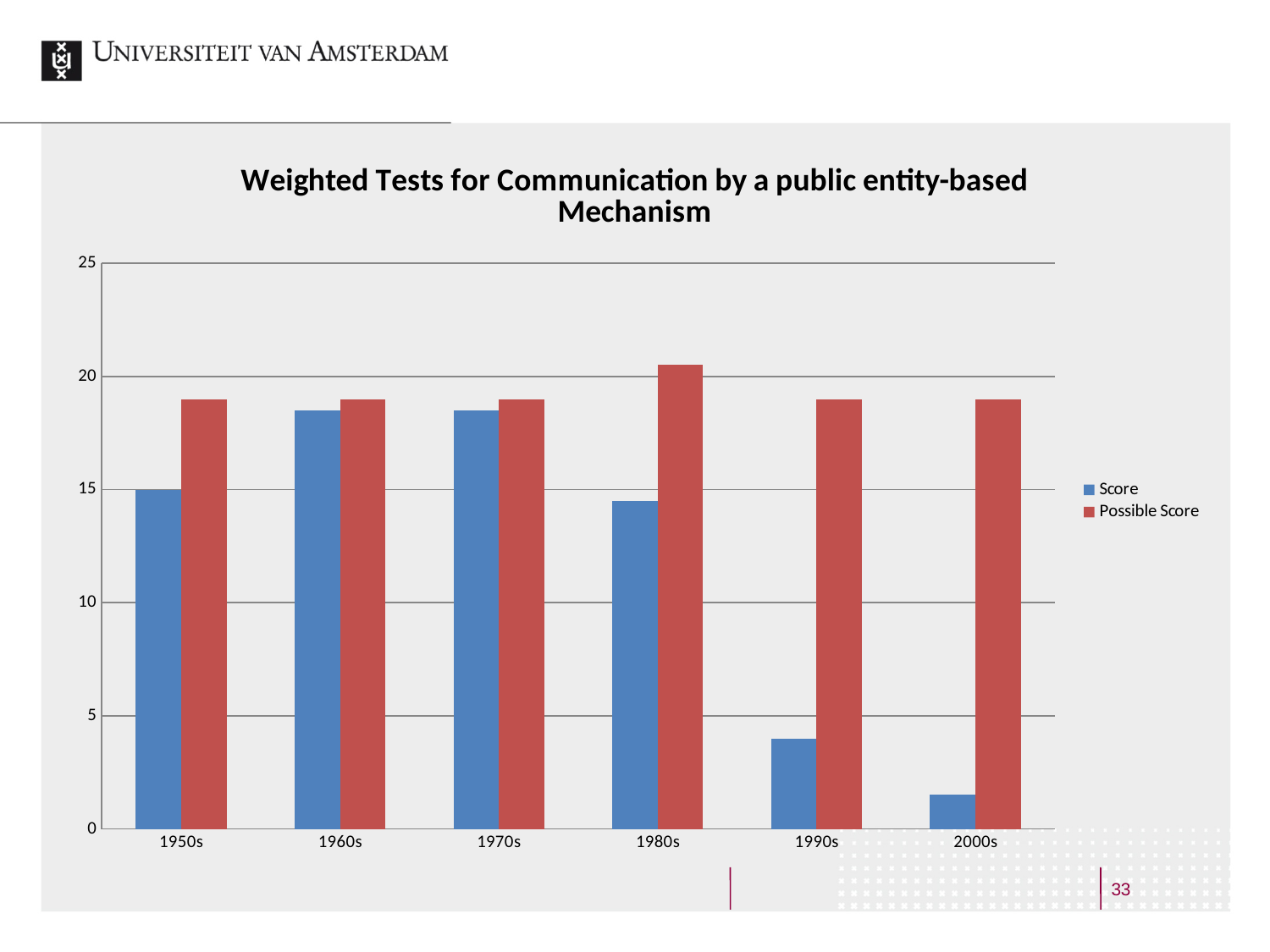
Is the Score for the 1960s greater or less than 15? greater How many series does the legend list? 2 How many decades are shown along the x axis? 6 Is the Score for the 1990s greater or less than 5? less Which is larger, the Score for the 1950s or the Score for the 1990s? 1950s What kind of chart is shown on the slide? bar chart Which decade has the highest Possible Score? 1980s Does the Score rise or fall from the 1970s to the 2000s? fall Which colour represents the Possible Score series? red Which decade has the lowest Score? 2000s Is the Possible Score for the 1980s greater or less than 20? greater